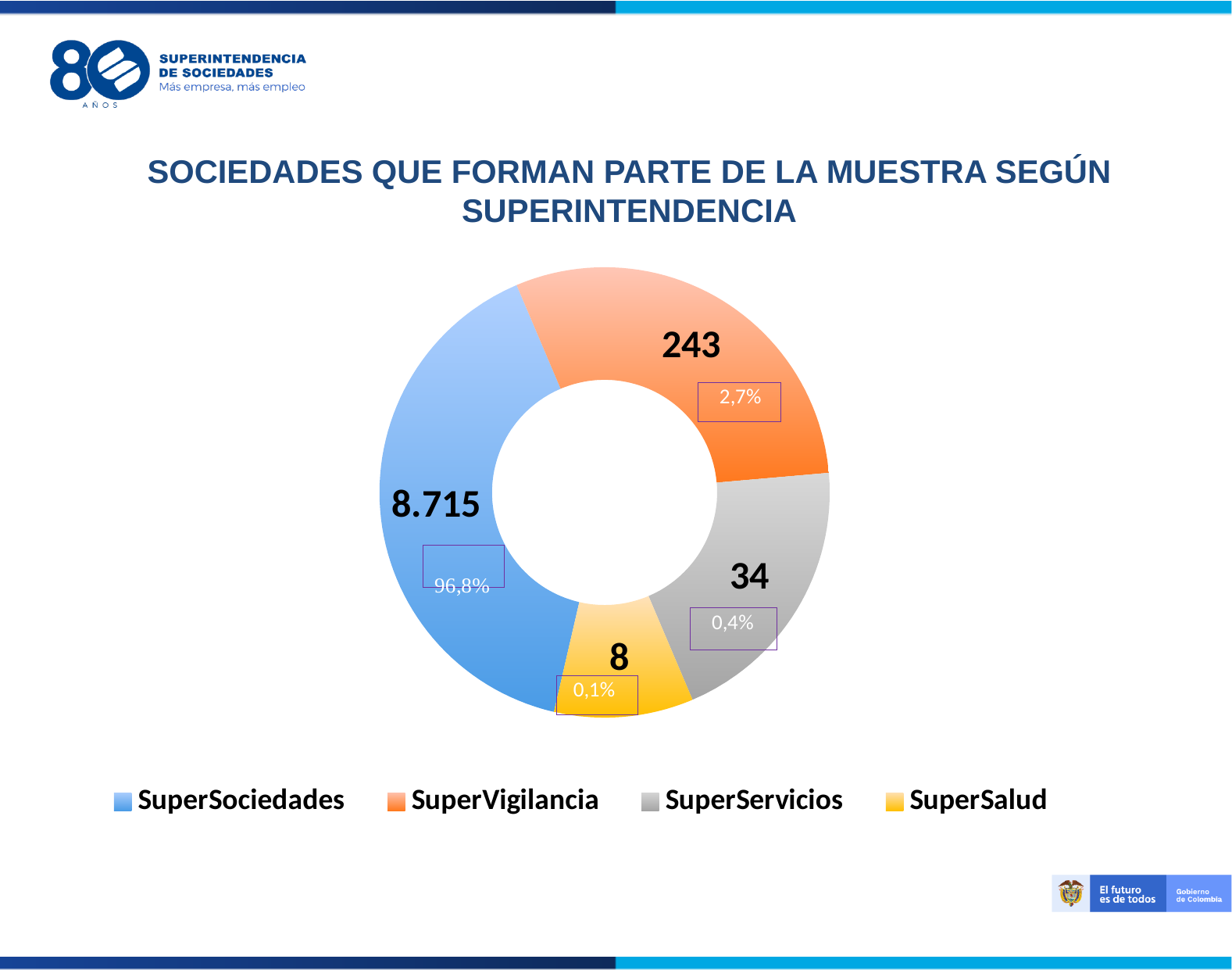
How many companies in the sample belong to SuperServicios? 34 How many companies in the sample belong to SuperSalud? 8 How many categories does the legend list? 4 What percentage of the sample does SuperSociedades represent? 96,8% What percentage of the sample does SuperVigilancia represent? 2,7% What kind of chart is shown on the slide? doughnut chart Which has more companies in the sample, SuperServicios or SuperSalud? SuperServicios Which superintendencia has the largest share of the sample? SuperSociedades How many companies in the sample belong to SuperSociedades? 8.715 How many companies in the sample belong to SuperVigilancia? 243 Which superintendencia has the smallest share of the sample? SuperSalud What is the difference between the number of companies for SuperVigilancia and SuperServicios? 209